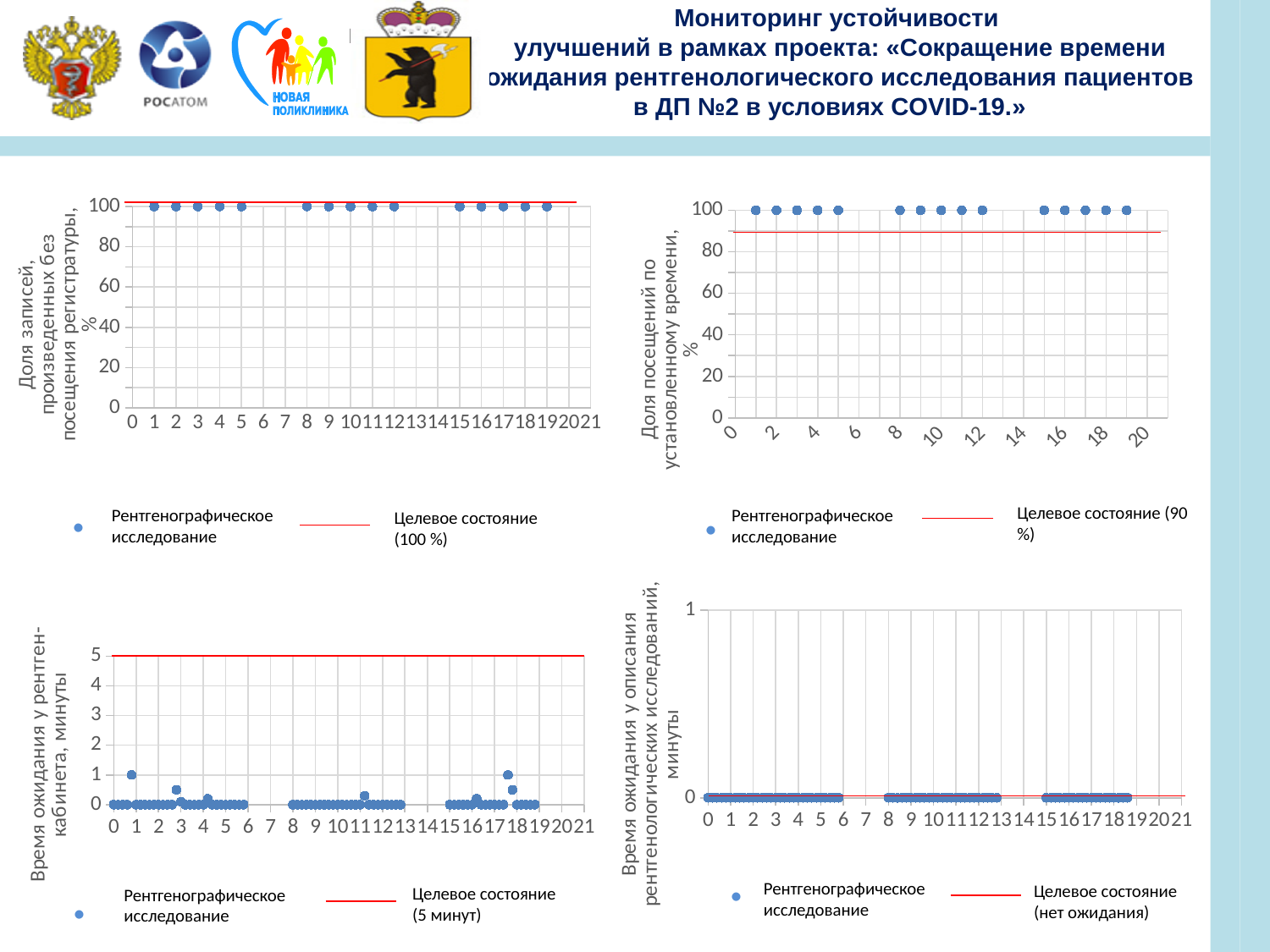
In the top-left chart, what is the target state value given in the legend? 100 % What kind of chart is the top-left chart (share of records made without visiting the registry)? scatter chart How many series does the legend of the bottom-right chart list? 2 In the bottom-left chart, is the highest plotted data point greater or less than 3 minutes? less In the bottom-left chart (waiting time at the X-ray room), what value does the red target line sit at on the y axis? 5 In the bottom-left chart, what is the maximum value shown on the y axis? 5 In the top-right chart, are the plotted data points above or below the red target line? above In the top-right chart (share of visits at the scheduled time), what is the target state value given in the legend? 90 % How many series does the legend of the top-left chart list? 2 In the top-right chart, is the value of the red target line greater or less than 80? greater In the bottom-right chart, is the value of the plotted points greater or less than 1 minute? less In the bottom-right chart (waiting time for the description of X-ray examinations), what is the maximum value shown on the y axis? 1